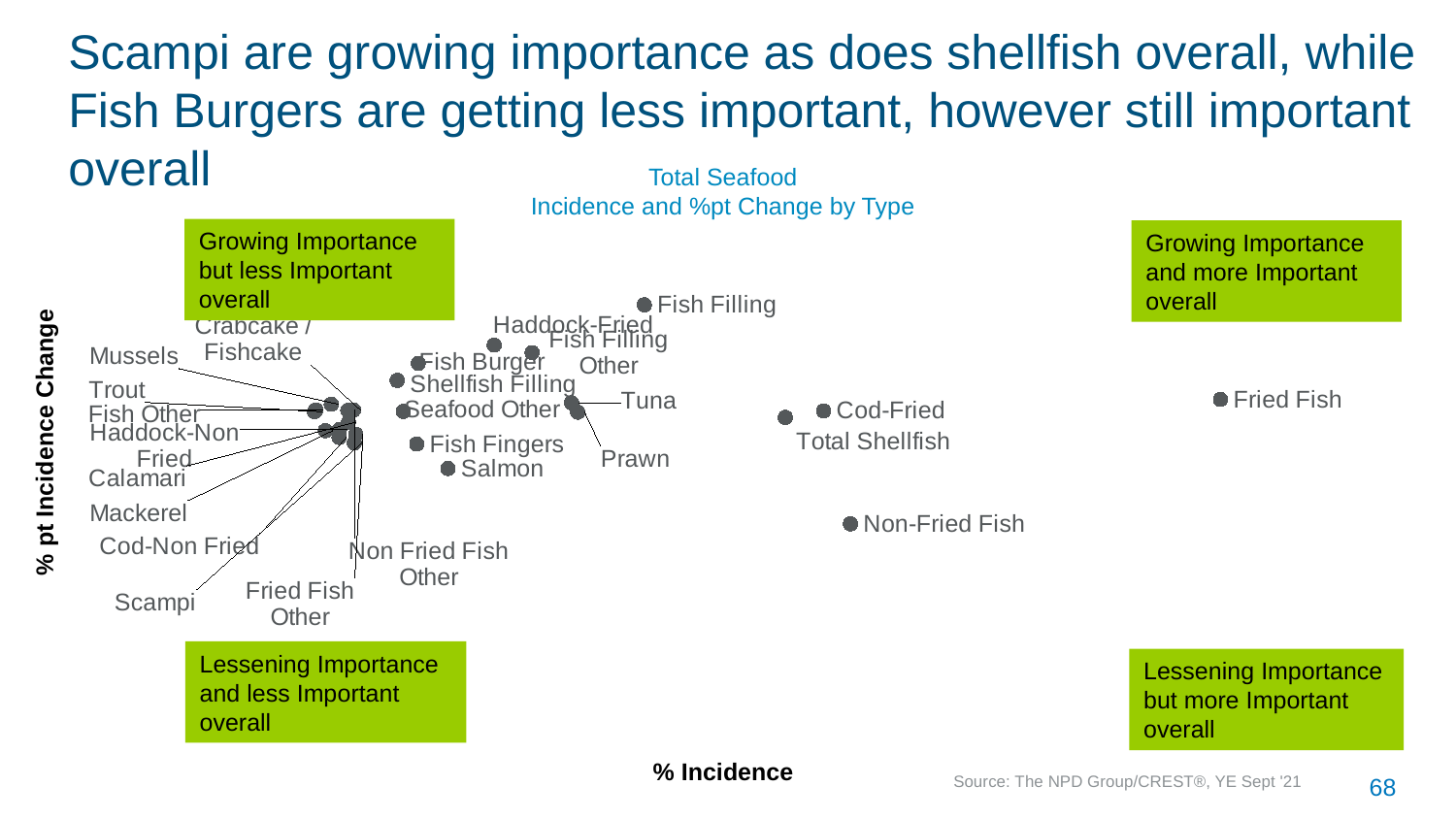
Which has the higher % Incidence, Fried Fish or Cod-Fried? Fried Fish Which seafood type has the lowest % pt Incidence Change (lowest point on the chart)? Non-Fried Fish Which seafood type has the highest % Incidence (furthest right on the chart)? Fried Fish Which has the higher % pt Incidence Change, Fish Filling or Salmon? Fish Filling Which seafood type has the highest % pt Incidence Change (highest point on the chart)? Fish Filling What kind of chart is shown on the slide? Scatter chart Which has the higher % Incidence, Total Shellfish or Scampi? Total Shellfish What is the title of the chart? Total Seafood Incidence and %pt Change by Type What is the label of the horizontal axis of the chart? % Incidence